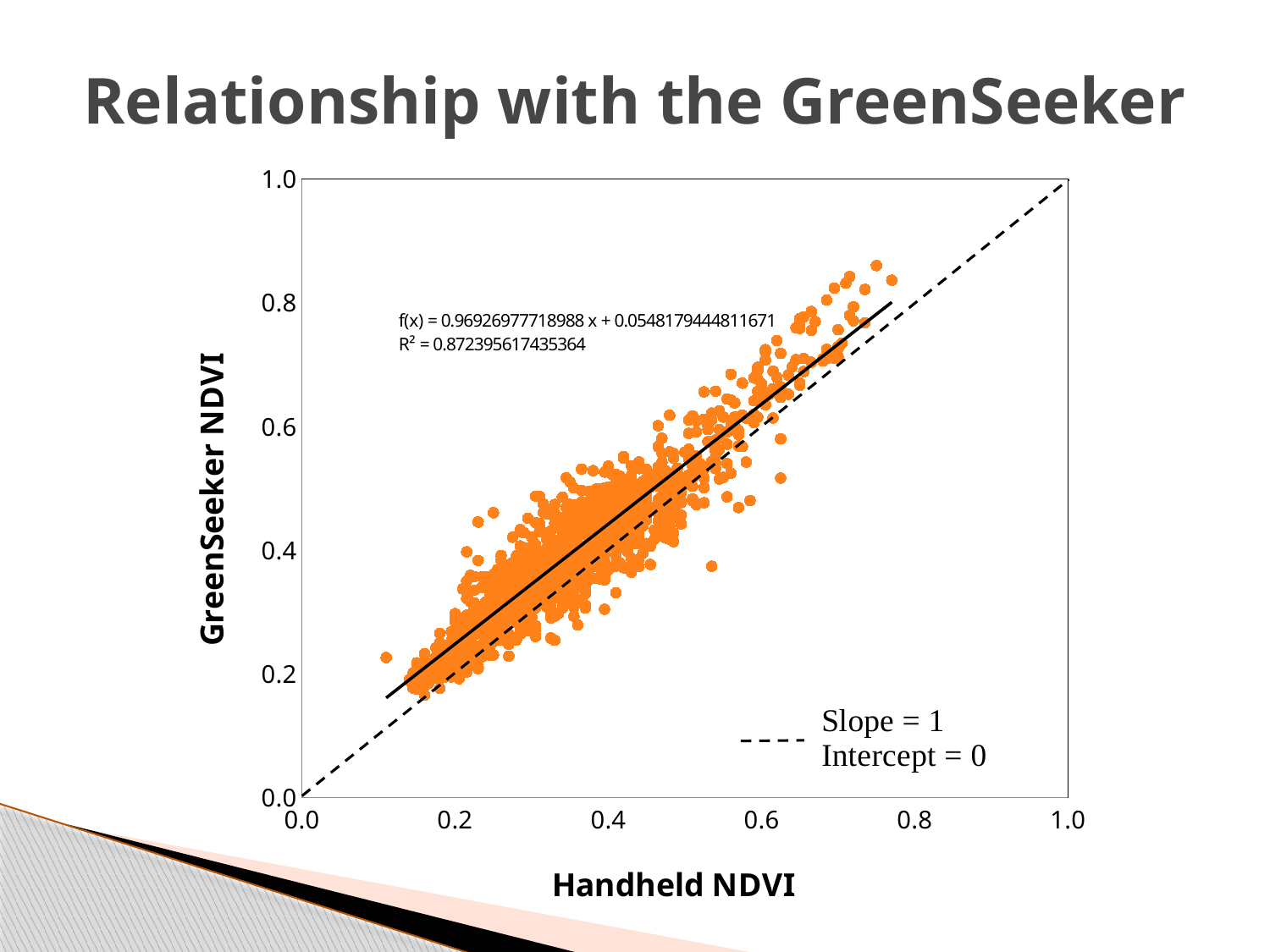
What is the slope of the fitted trendline equation printed on the chart? 0.96926977718988 What is the label of the y axis? GreenSeeker NDVI What is the label of the x axis? Handheld NDVI What is the maximum value shown on the x axis? 1.0 Do the GreenSeeker NDVI values rise or fall as Handheld NDVI increases? Rise What is the intercept of the fitted trendline equation printed on the chart? 0.0548179444811671 What kind of chart is shown on the slide? Scatter chart What is the maximum value shown on the y axis? 1.0 What is the title of the slide's chart? Relationship with the GreenSeeker What R² value is printed on the chart for the fitted line? 0.872395617435364 What slope and intercept does the dashed reference line represent? Slope = 1, Intercept = 0 Is the fitted trendline's slope greater or less than 1? less